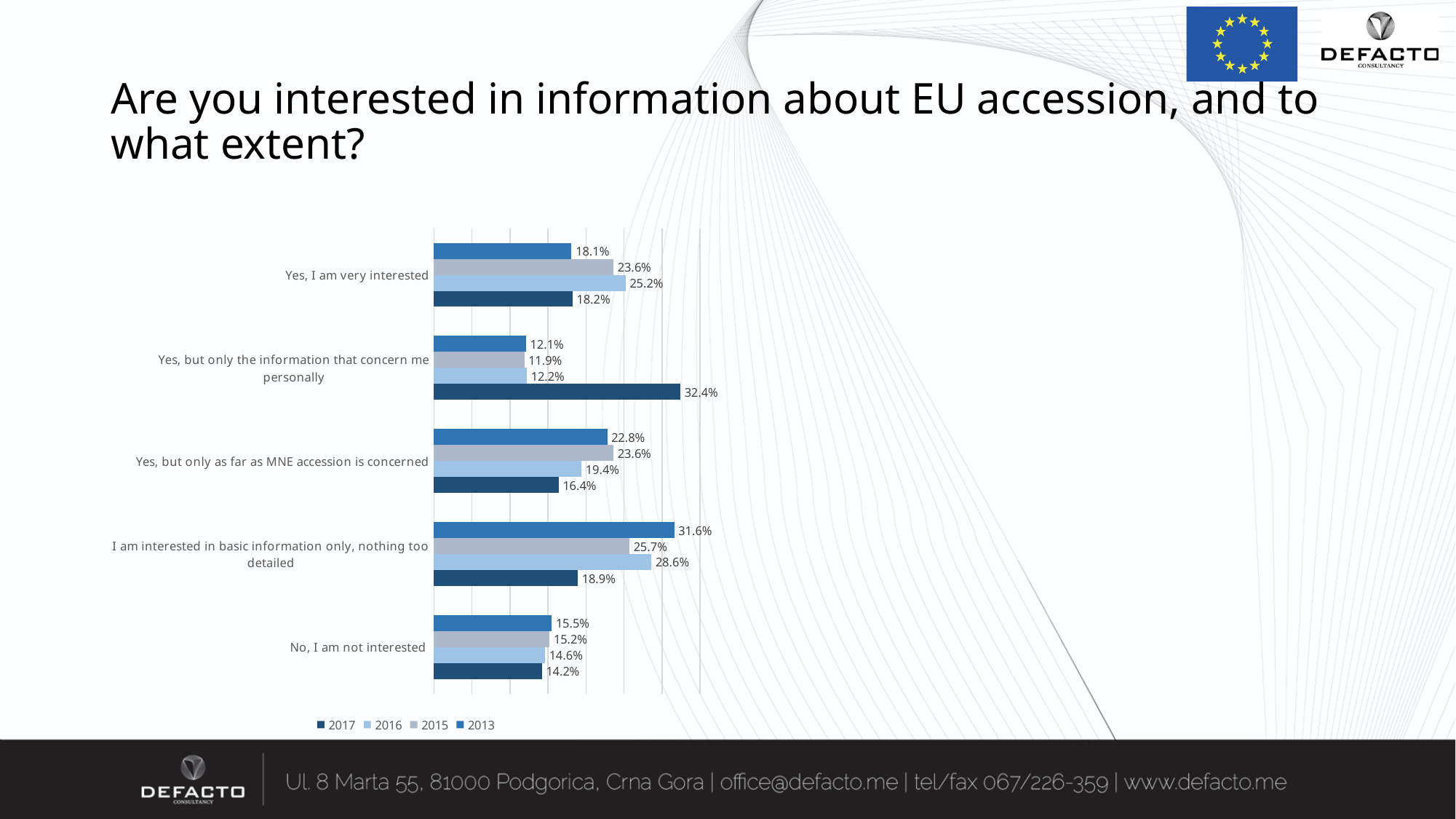
Which years are listed in the chart legend? 2017, 2016, 2015, 2013 Which response category has the lowest 2017 value? No, I am not interested What is the 2017 value for "Yes, I am very interested"? 18.2% How many response categories are shown in the chart? 5 What is the 2017 value for "Yes, but only the information that concern me personally"? 32.4% What is the 2013 value for "I am interested in basic information only, nothing too detailed"? 31.6% What type of chart is shown on the slide? bar chart Which response category has the highest 2017 value? Yes, but only the information that concern me personally For "Yes, but only as far as MNE accession is concerned", which is larger: the 2013 value or the 2017 value? 2013 What is the difference between the 2017 and 2013 values for "Yes, but only the information that concern me personally"? 20.3% What is the 2017 value for "No, I am not interested"? 14.2% How many series does the legend list? 4